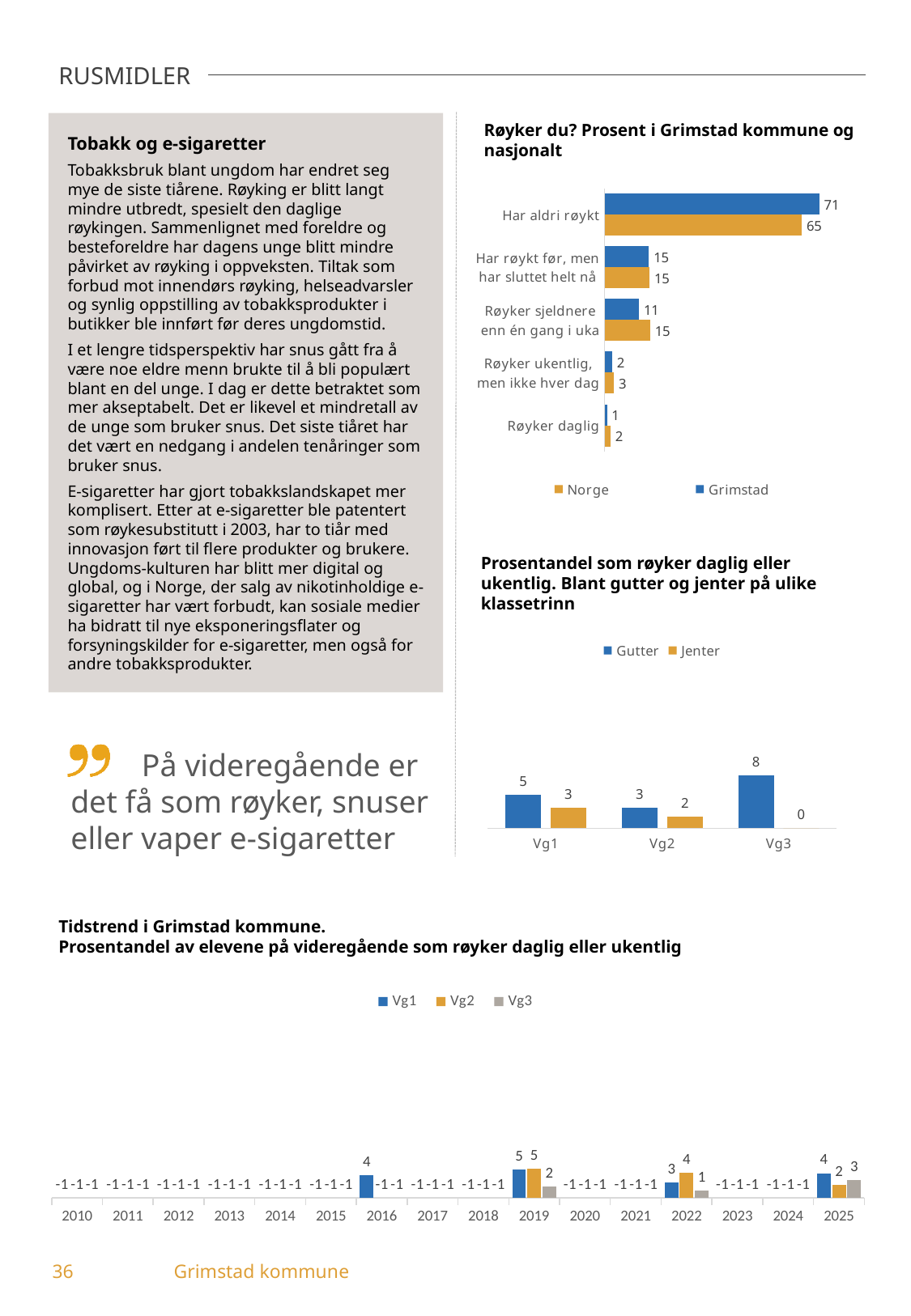
In the chart 'Prosentandel som røyker daglig eller ukentlig', what is the value for Gutter at Vg3? 8 How many series does the legend list in the chart 'Tidstrend i Grimstad kommune'? 3 In the chart 'Røyker du? Prosent i Grimstad kommune og nasjonalt', what is the difference between the Grimstad and Norge values for 'Har aldri røykt'? 6 In the chart 'Prosentandel som røyker daglig eller ukentlig', is the Gutter value or the Jenter value larger at Vg1? Gutter In the chart 'Røyker du? Prosent i Grimstad kommune og nasjonalt', what is the Norge value for 'Røyker sjeldnere enn én gang i uka'? 15 How many series does the legend list in the chart 'Røyker du? Prosent i Grimstad kommune og nasjonalt'? 2 In the chart 'Prosentandel som røyker daglig eller ukentlig', which class level has the highest Gutter value? Vg3 What kind of chart is 'Røyker du? Prosent i Grimstad kommune og nasjonalt'? Bar chart In the chart 'Tidstrend i Grimstad kommune', what is the Vg2 value for 2022? 4 In the chart 'Prosentandel som røyker daglig eller ukentlig', what is the difference between Gutter and Jenter at Vg2? 1 In the chart 'Røyker du? Prosent i Grimstad kommune og nasjonalt', what is the Grimstad value for 'Har aldri røykt'? 71 In the chart 'Røyker du? Prosent i Grimstad kommune og nasjonalt', which category has the lowest Grimstad value? Røyker daglig